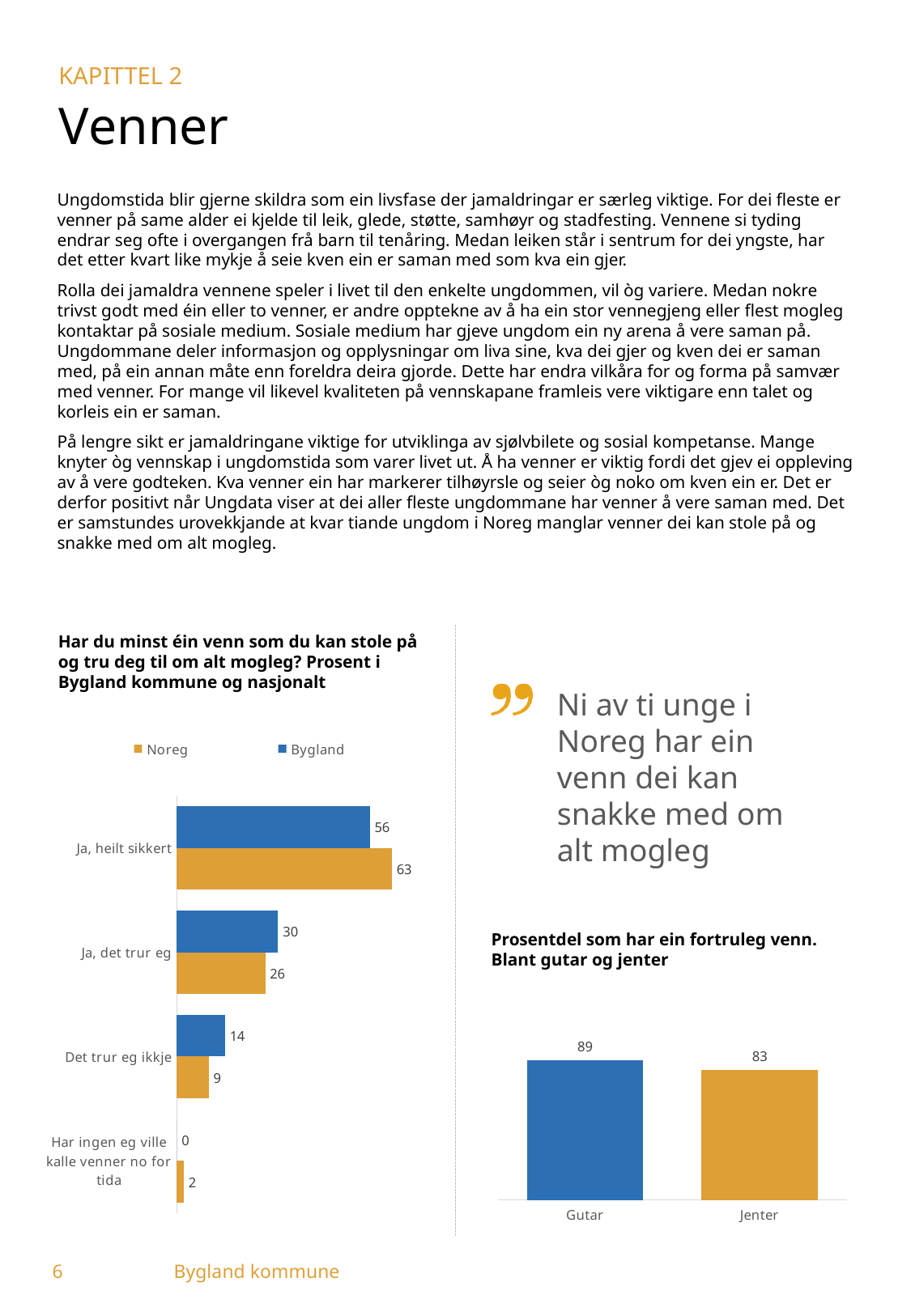
In the chart 'Prosentdel som har ein fortruleg venn. Blant gutar og jenter', what is the difference between Gutar and Jenter? 6 In the chart 'Har du minst éin venn som du kan stole på og tru deg til om alt mogleg?', what is the difference between Noreg and Bygland for 'Ja, heilt sikkert'? 7 In the chart 'Har du minst éin venn som du kan stole på og tru deg til om alt mogleg?', how many categories are shown? 4 What kind of chart is 'Har du minst éin venn som du kan stole på og tru deg til om alt mogleg?'? Bar chart In the chart 'Har du minst éin venn som du kan stole på og tru deg til om alt mogleg?', which category has the highest value for Bygland? Ja, heilt sikkert In the chart 'Prosentdel som har ein fortruleg venn. Blant gutar og jenter', what is the value for Jenter? 83 In the chart 'Har du minst éin venn som du kan stole på og tru deg til om alt mogleg?', what is the value for Noreg for 'Det trur eg ikkje'? 9 In the chart 'Prosentdel som har ein fortruleg venn. Blant gutar og jenter', which category has the highest value? Gutar In the chart 'Har du minst éin venn som du kan stole på og tru deg til om alt mogleg?', how many series does the legend list? 2 In the chart 'Har du minst éin venn som du kan stole på og tru deg til om alt mogleg?', which is larger for 'Ja, det trur eg': Noreg or Bygland? Bygland In the chart 'Har du minst éin venn som du kan stole på og tru deg til om alt mogleg?', what is the value for Bygland for 'Ja, heilt sikkert'? 56 In the chart 'Har du minst éin venn som du kan stole på og tru deg til om alt mogleg?', what is the value for Noreg for 'Ja, heilt sikkert'? 63